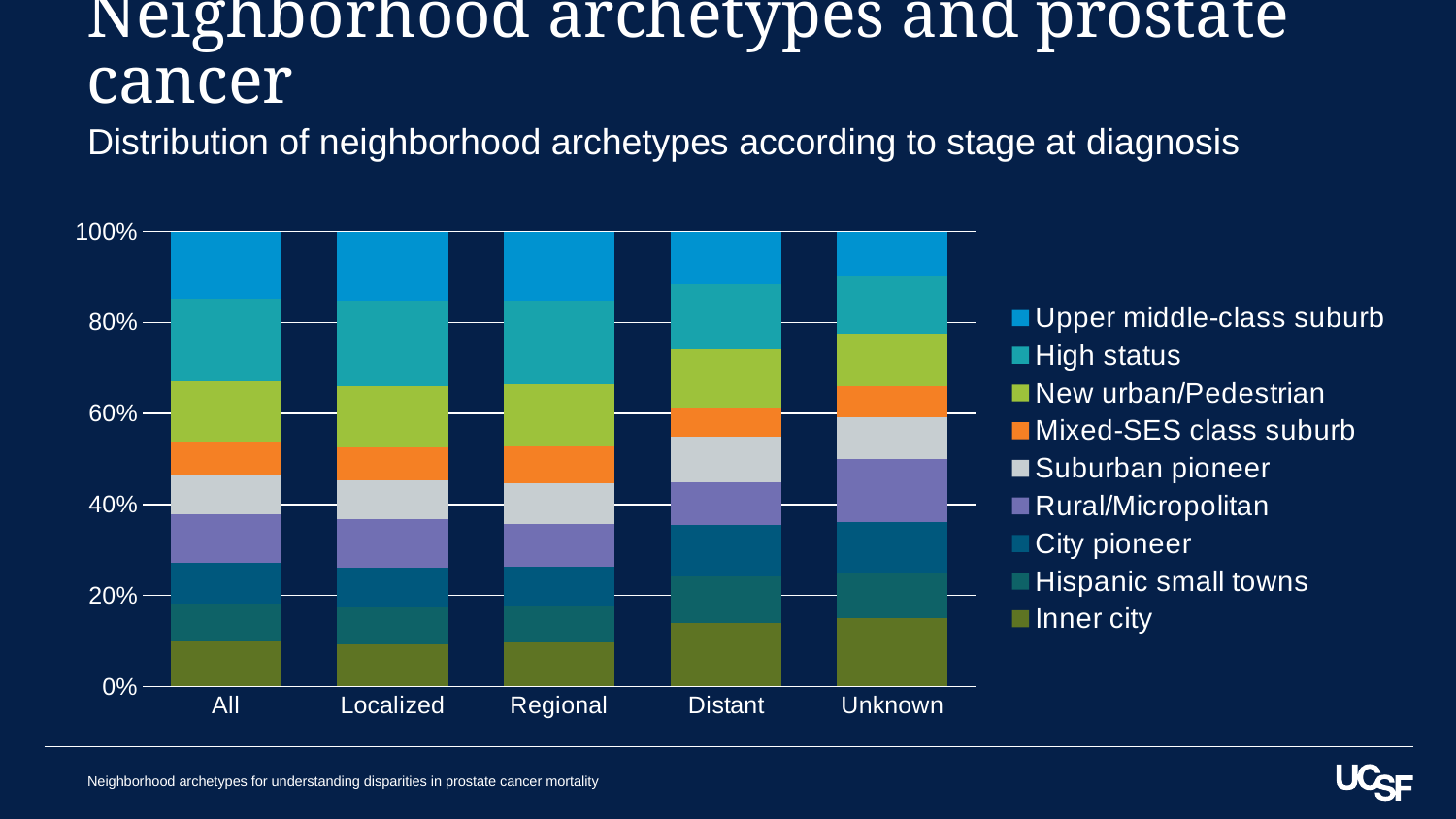
What is the subtitle describing the chart? Distribution of neighborhood archetypes according to stage at diagnosis What kind of chart is shown on the slide? Stacked bar chart Is the Inner city share for Distant greater or less than 10%? greater How many neighborhood archetypes does the legend list? 9 Is the Inner city share for Unknown greater or less than 20%? less Which stage has the larger Upper middle-class suburb share, Localized or Unknown? Localized What is the total of the stacked bar for Localized? 100% Which neighborhood archetype is listed first in the legend? Upper middle-class suburb Which stage has the larger Inner city share, Localized or Distant? Distant Is the Upper middle-class suburb share for Unknown greater or less than 20%? less How many stage categories are shown along the x axis? 5